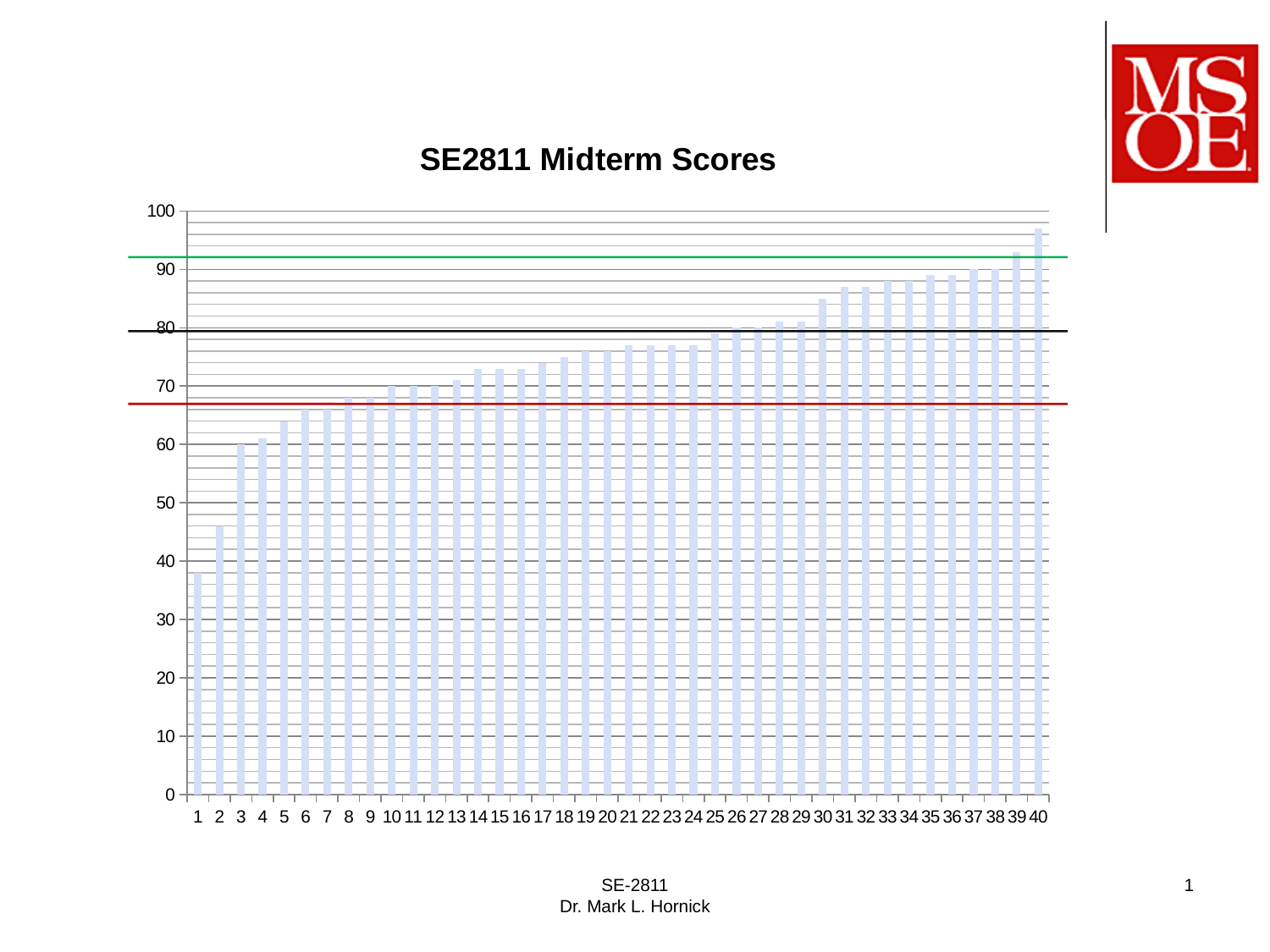
Is the value for category 2 greater or less than 40? greater How many bars are plotted in the chart? 40 What kind of chart is shown on the slide? bar chart Do the bar values rise or fall from category 1 to category 40? rise How many horizontal reference lines are drawn across the chart in addition to the gridlines? 3 Which is larger, the value for category 2 or the value for category 3? category 3 Which category has the highest bar? 40 What is the title of the chart? SE2811 Midterm Scores Which category has the lowest bar? 1 Is the value for category 1 greater or less than 40? less Is the value for category 20 greater or less than 80? less